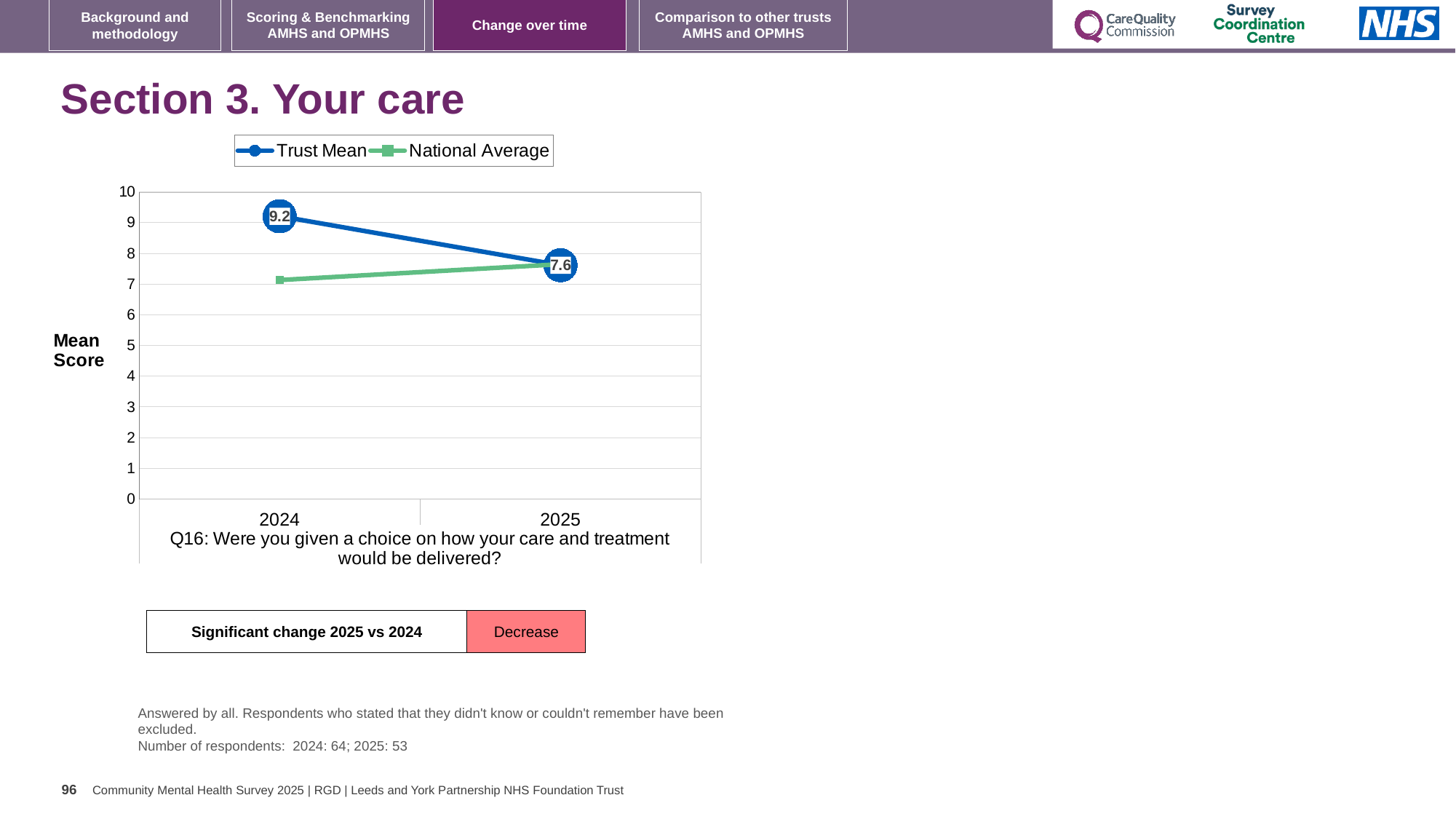
How many years are shown on the x axis? 2 What type of chart is shown on the slide? Line chart What is the Trust Mean score for 2025? 7.6 What is the Trust Mean score for 2024? 9.2 By how much did the Trust Mean fall from 2024 to 2025? 1.6 Which year has the higher Trust Mean score, 2024 or 2025? 2024 Does the National Average rise or fall from 2024 to 2025? Rise In 2024, which is higher, the Trust Mean or the National Average? Trust Mean Is the National Average for 2024 greater or less than 8? less Does the Trust Mean rise or fall from 2024 to 2025? Fall How many series does the legend list? 2